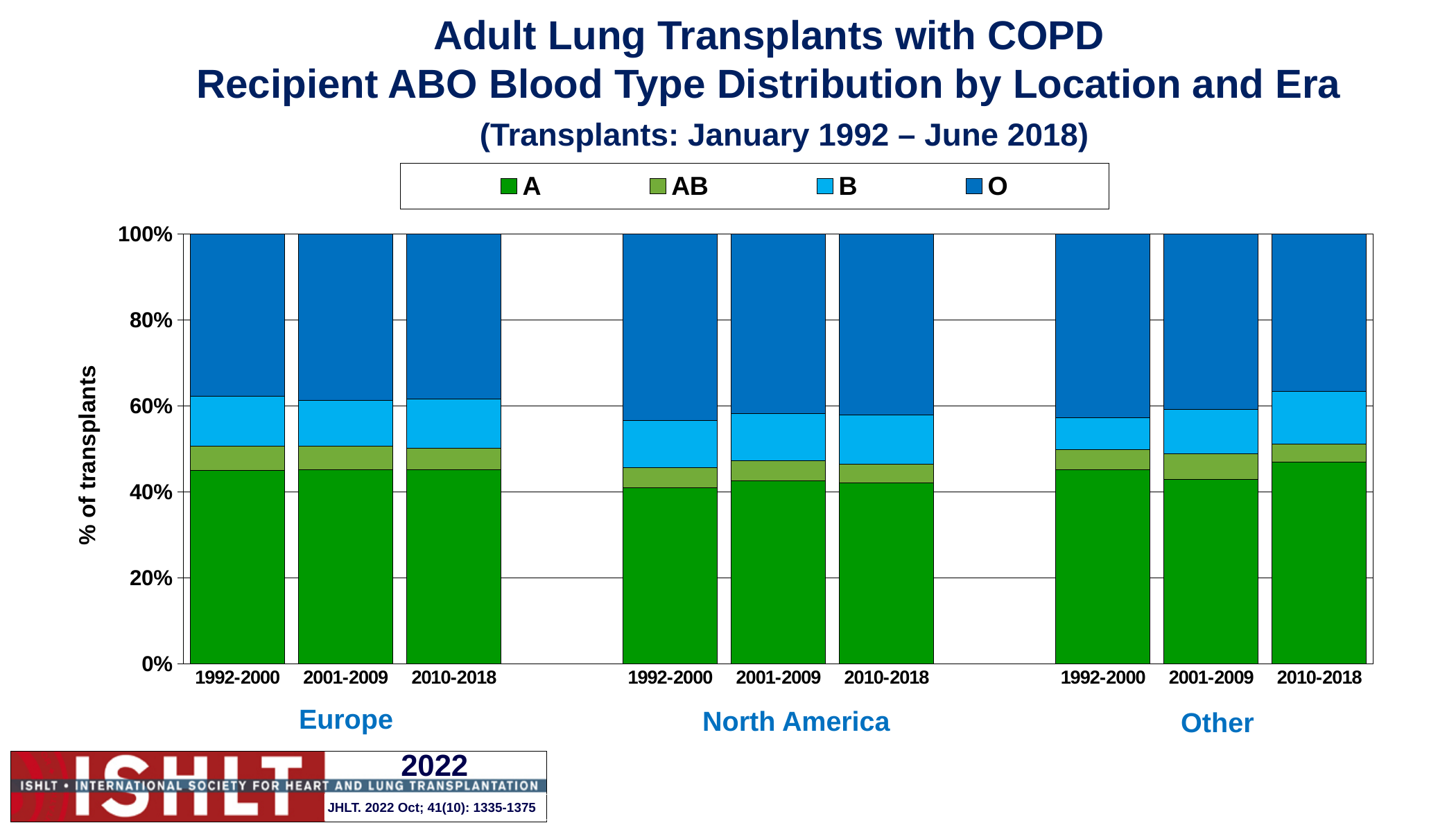
Is the combined share of blood types A, AB and B for Other 2010-2018 greater or less than 60%? greater How many location groups are shown along the x axis? 3 What is the label of the y axis? % of transplants What kind of chart is shown on the slide? Stacked bar chart How many series does the legend list? 4 Is the share of blood type A for Europe 1992-2000 greater or less than 40%? greater Which blood type series is shown in dark blue in the legend? O Is the share of blood type O for North America 1992-2000 greater or less than 40%? greater How many stacked bars are plotted in the chart? 9 Which has the larger share of blood type A: Other 2010-2018 or North America 1992-2000? Other 2010-2018 What does each stacked bar total? 100%